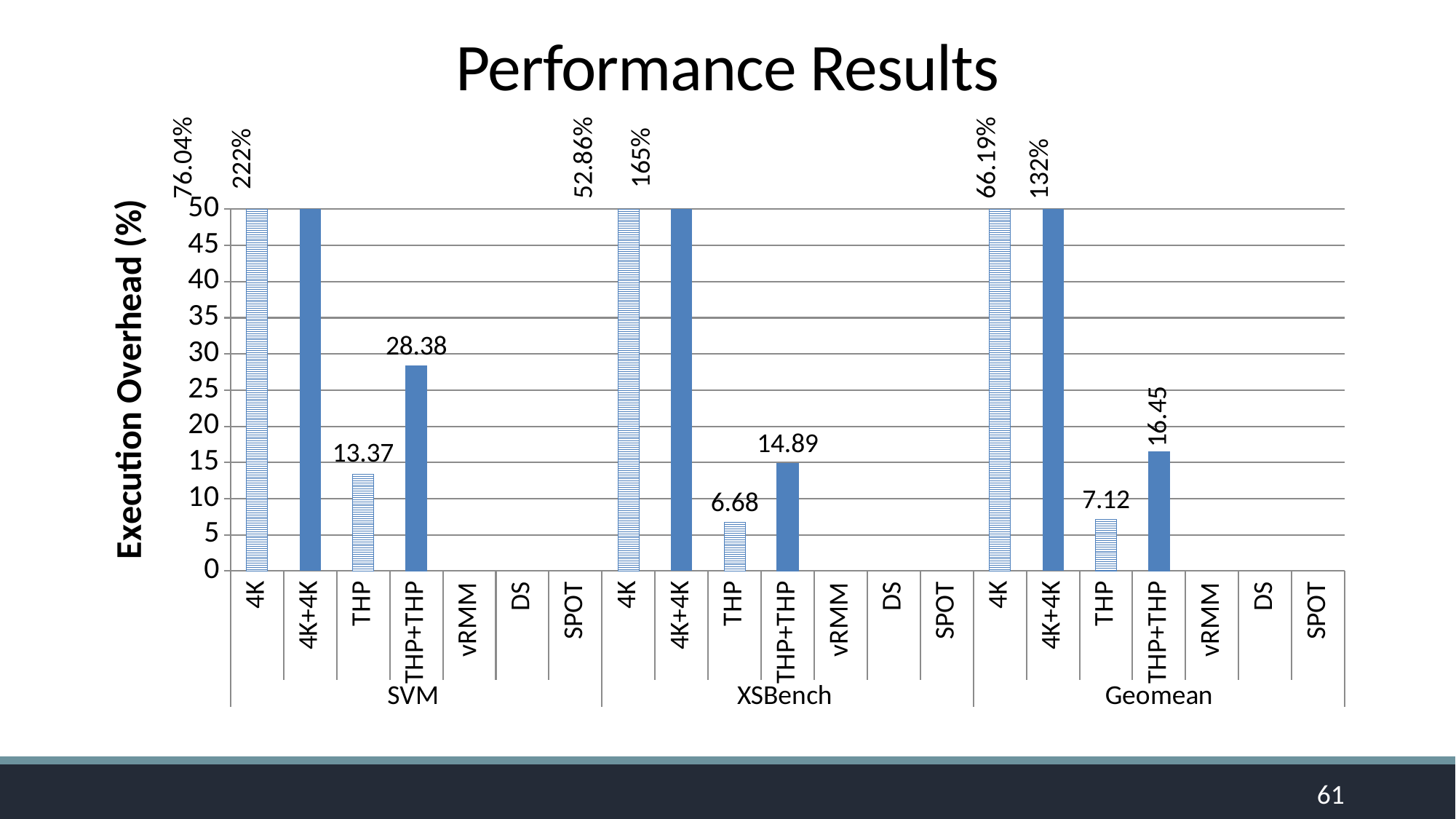
What is the difference between the THP+THP and THP values in the SVM group? 15.01 What is the execution overhead for THP in the Geomean group? 7.12 What is the execution overhead for THP+THP in the SVM group? 28.38 Which has a higher THP execution overhead, SVM or XSBench? SVM What is the difference between the THP+THP and THP values in the XSBench group? 8.21 Is the value for THP+THP in the SVM group greater or less than 25? greater What kind of chart is shown on the slide? bar chart What is the execution overhead for THP+THP in the Geomean group? 16.45 What is the execution overhead for THP in the SVM group? 13.37 What is the execution overhead for THP in the XSBench group? 6.68 What is the execution overhead for THP+THP in the XSBench group? 14.89 What is the title of the vertical axis? Execution Overhead (%)